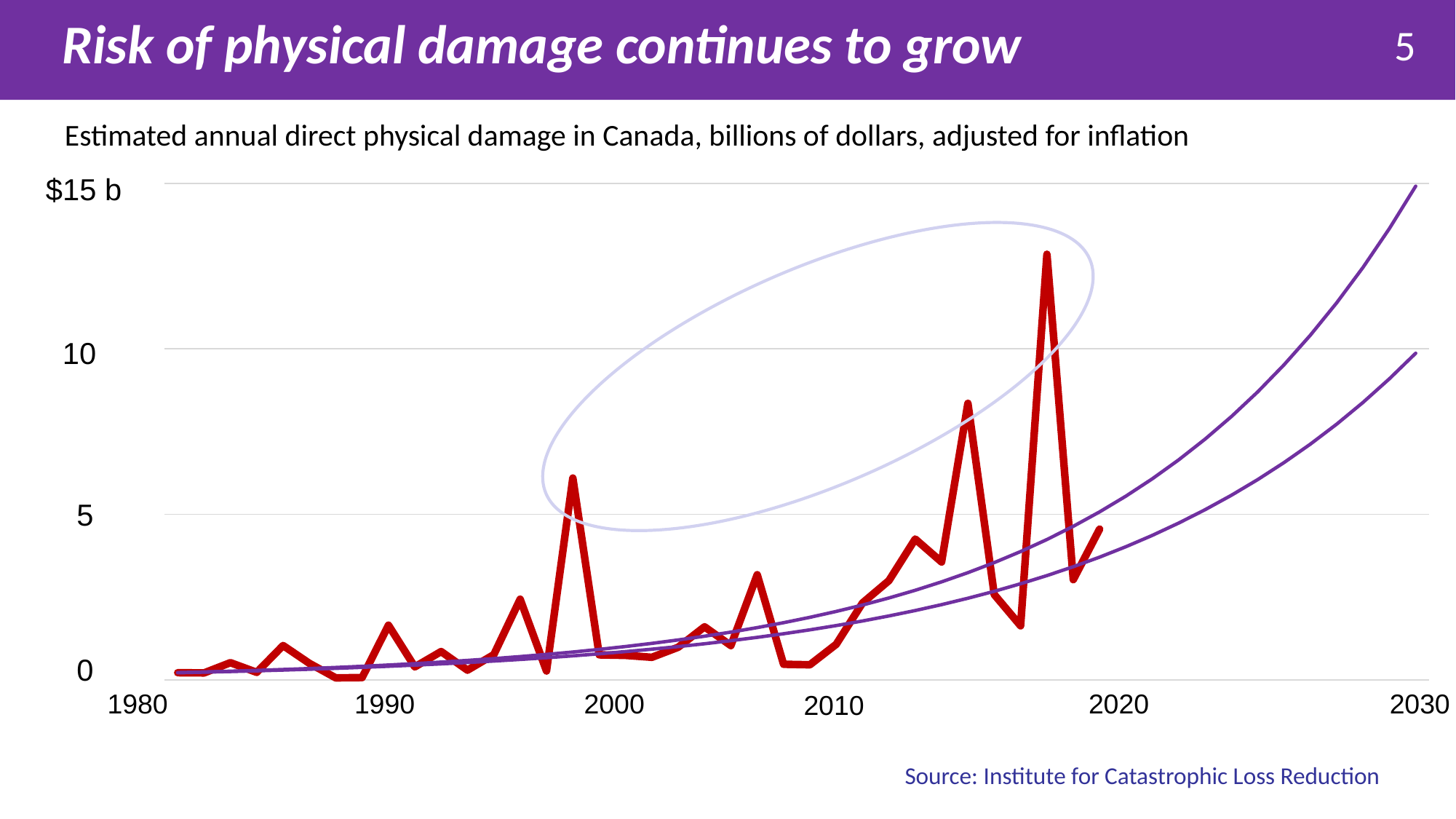
What kind of chart is shown on the slide? line chart What is the title of the slide containing the chart? Risk of physical damage continues to grow Is the value of the upper purple curve at 2030 greater or less than 10? greater Does the red line reach its highest value before or after 2010? after What does the chart's subtitle say is being plotted? Estimated annual direct physical damage in Canada, billions of dollars, adjusted for inflation Is the red line's peak around 2015 greater or less than 10? less Is the highest peak of the red line greater or less than 10? greater How many purple trend curves are drawn on the chart? 2 Do the purple trend curves rise or fall from 1980 to 2030? rise What is the highest value labelled on the vertical axis? $15 b